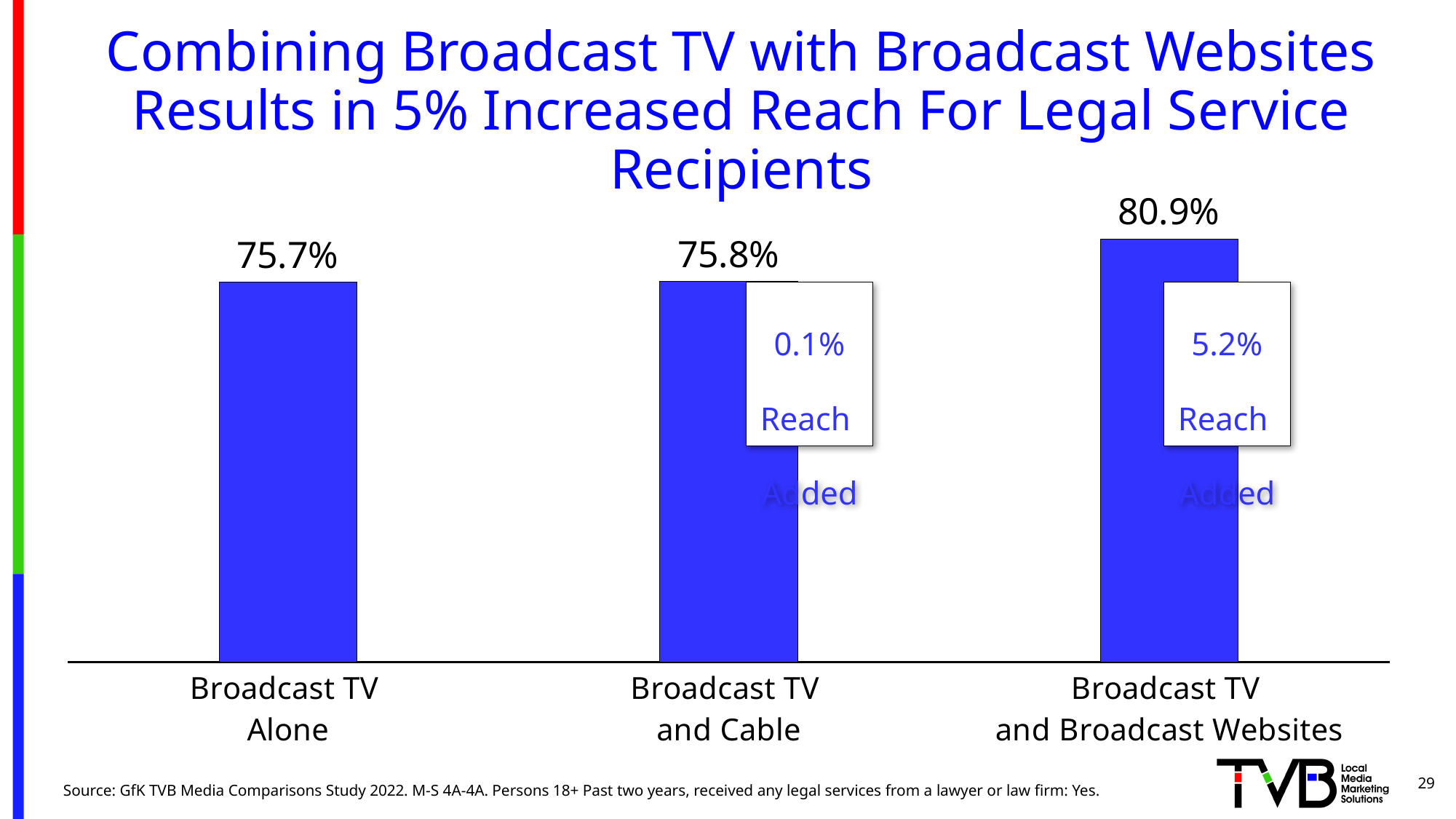
What added reach is labeled in the callout box for Broadcast TV and Broadcast Websites? 5.2% Reach Added Do the reach values rise or fall from left to right across the categories? Rise How many categories are shown on the chart? 3 What is the difference in reach between Broadcast TV and Broadcast Websites and Broadcast TV Alone? 5.2% What is the reach value for Broadcast TV and Cable? 75.8% What is the reach value for Broadcast TV Alone? 75.7% What kind of chart is shown on the slide? Bar chart Which is larger: the reach for Broadcast TV and Broadcast Websites or the reach for Broadcast TV and Cable? Broadcast TV and Broadcast Websites What is the difference in reach between Broadcast TV and Cable and Broadcast TV Alone? 0.1% What colour are the bars in the chart? Blue What is the reach value for Broadcast TV and Broadcast Websites? 80.9% Which category has the highest reach? Broadcast TV and Broadcast Websites